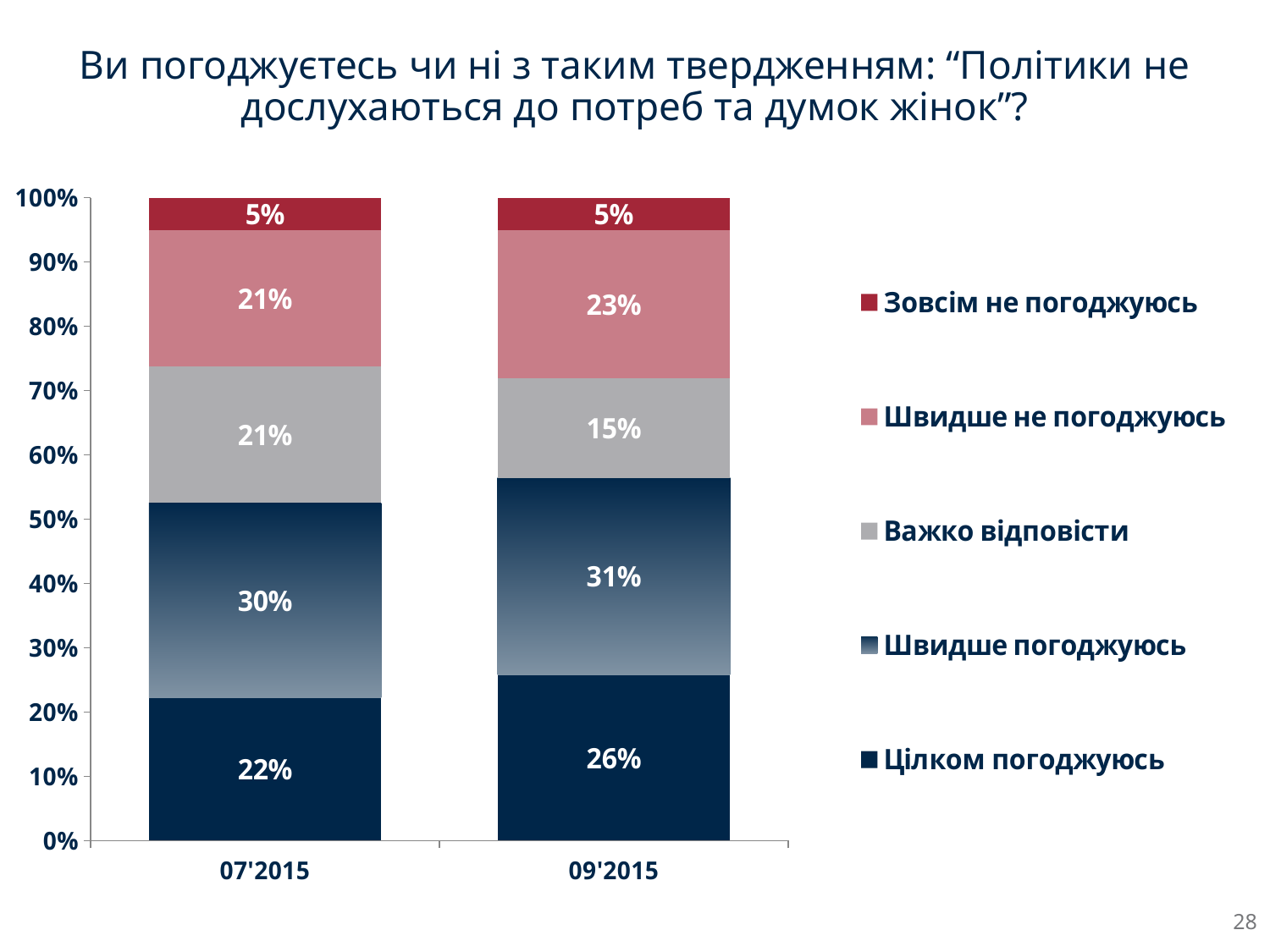
Does the value for "Швидше погоджуюсь" rise or fall from 07'2015 to 09'2015? Rise Which series has the lowest value in the 07'2015 bar? Зовсім не погоджуюсь Which is larger: "Цілком погоджуюсь" in 07'2015 or in 09'2015? 09'2015 What is the value for "Зовсім не погоджуюсь" in 07'2015? 5% Which series has the highest value in the 09'2015 bar? Швидше погоджуюсь What is the difference between the "Важко відповісти" values for 07'2015 and 09'2015? 6% What is the value for "Важко відповісти" in 07'2015? 21% How many categories are shown on the x axis? 2 What is the value for "Швидше не погоджуюсь" in 09'2015? 23% What kind of chart is shown on the slide? Stacked bar chart What is the value for "Цілком погоджуюсь" in 09'2015? 26% How many series does the legend list? 5